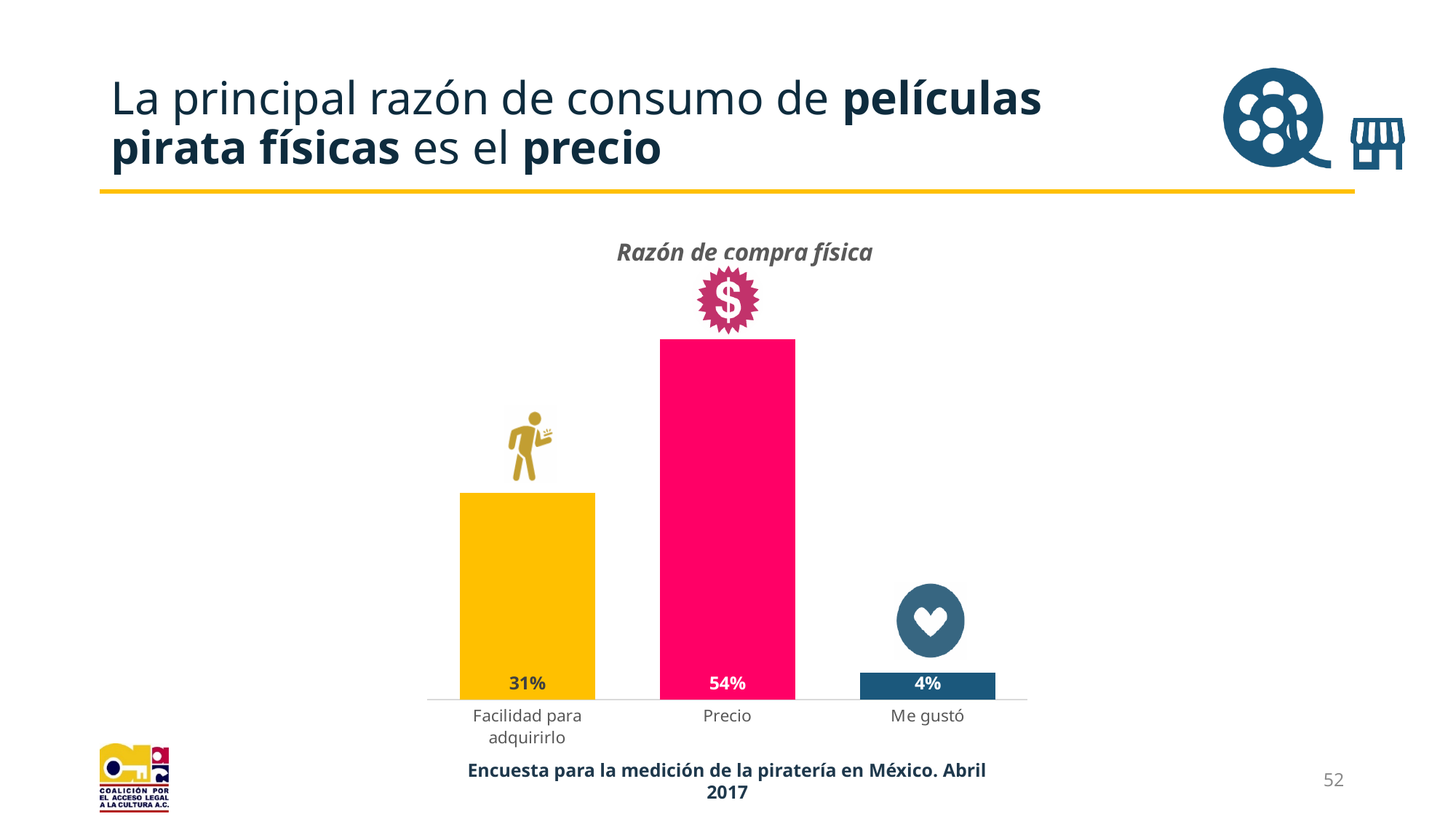
What is the value for Me gustó? 4% What is the difference between the values for Facilidad para adquirirlo and Me gustó? 27% Which category has the highest value? Precio What is the title of the chart? Razón de compra física What is the value for Precio? 54% What is the value for Facilidad para adquirirlo? 31% What colour is the bar for Precio? Pink Which category has the lowest value? Me gustó What is the difference between the values for Precio and Facilidad para adquirirlo? 23% Which is larger, the value for Precio or the value for Me gustó? Precio What kind of chart is shown on the slide? Bar chart How many categories are shown in the chart? 3